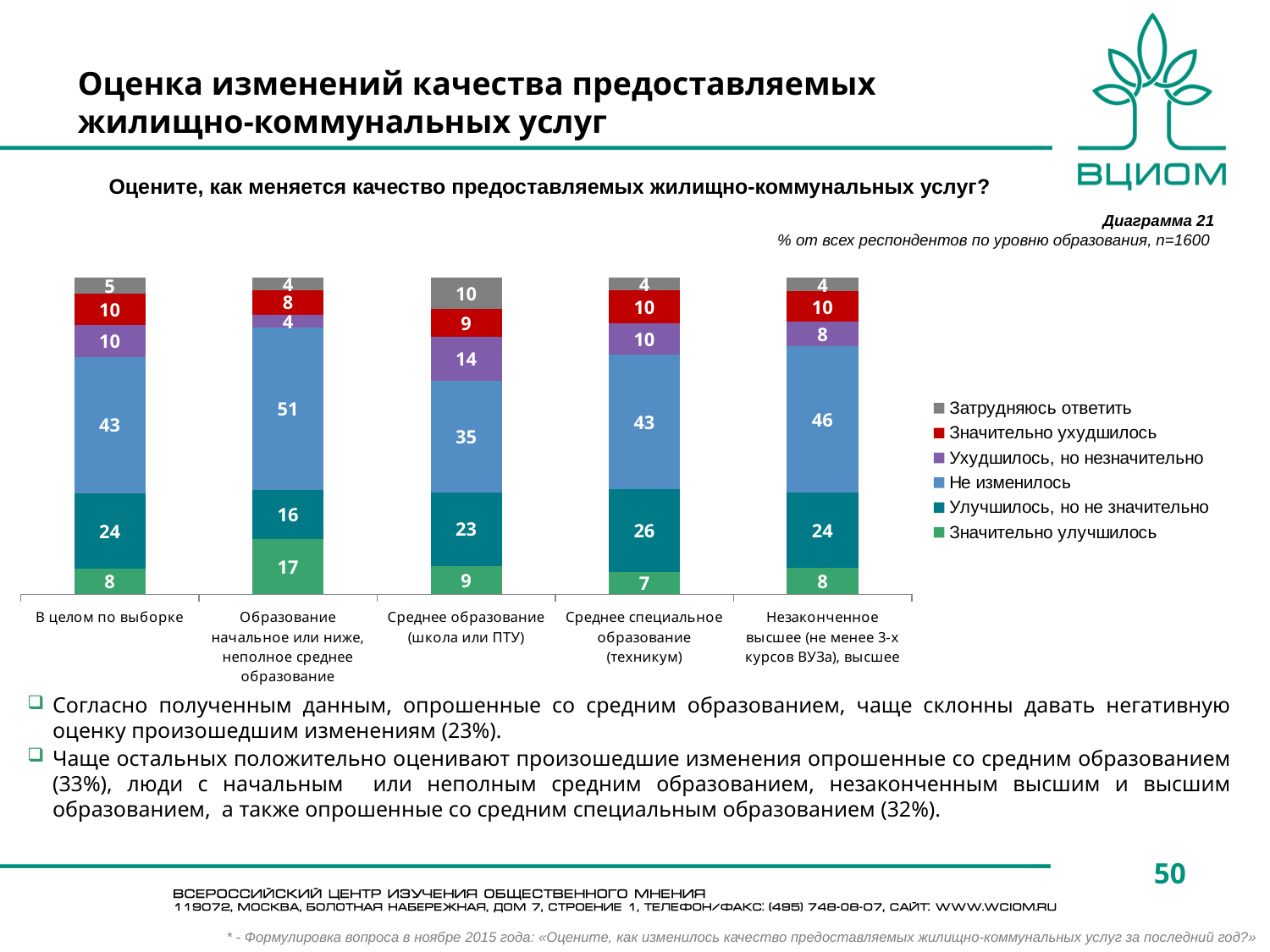
What is the value of "Не изменилось" for "Образование начальное или ниже, неполное среднее образование"? 51 Which legend entry is shown in red? Значительно ухудшилось Which is larger: "Значительно улучшилось" for "Образование начальное или ниже, неполное среднее образование" or for "В целом по выборке"? Образование начальное или ниже, неполное среднее образование Which category has the highest value for "Не изменилось"? Образование начальное или ниже, неполное среднее образование What is the difference between the "Не изменилось" values for "Незаконченное высшее (не менее 3-х курсов ВУЗа), высшее" and "Среднее образование (школа или ПТУ)"? 11 How many series does the legend list? 6 How many education categories are shown on the x axis? 5 What is the total of the stacked bar for "В целом по выборке"? 100 What is the value of "Ухудшилось, но незначительно" for "Среднее образование (школа или ПТУ)"? 14 What type of chart is shown on the slide? Stacked bar chart What is the value of "Значительно улучшилось" for "Среднее специальное образование (техникум)"? 7 Which category has the lowest value for "Улучшилось, но не значительно"? Образование начальное или ниже, неполное среднее образование